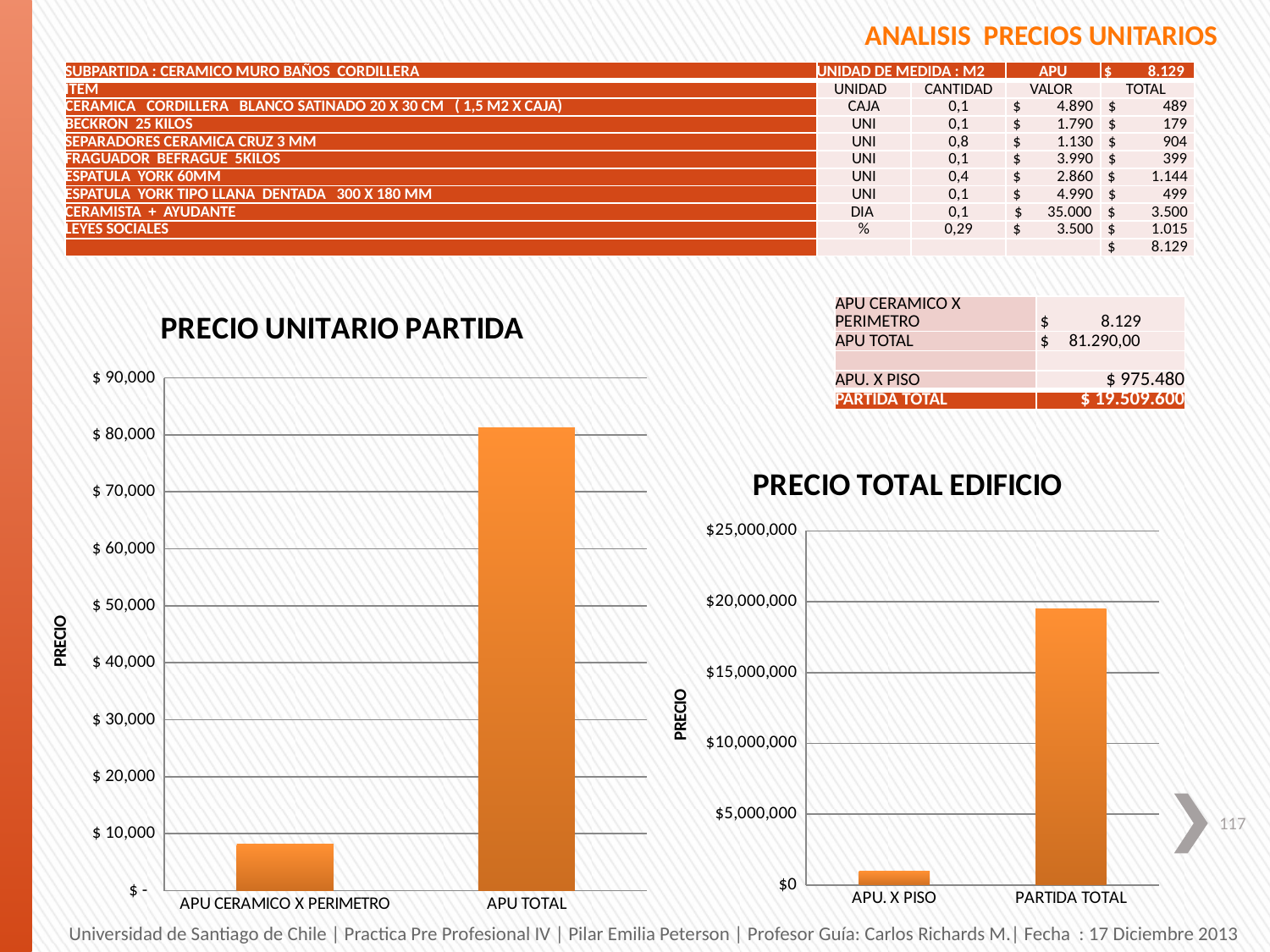
What kind of chart is the 'PRECIO UNITARIO PARTIDA' chart? bar chart In the 'PRECIO UNITARIO PARTIDA' chart, which category has the highest value? APU TOTAL What kind of chart is the 'PRECIO TOTAL EDIFICIO' chart? bar chart In the 'PRECIO UNITARIO PARTIDA' chart, is the value for APU CERAMICO X PERIMETRO greater or less than $ 10,000? less In the 'PRECIO TOTAL EDIFICIO' chart, is the value for PARTIDA TOTAL greater or less than $20,000,000? less In the 'PRECIO TOTAL EDIFICIO' chart, which is larger, APU. X PISO or PARTIDA TOTAL? PARTIDA TOTAL In the 'PRECIO UNITARIO PARTIDA' chart, which category has the lowest value? APU CERAMICO X PERIMETRO In the 'PRECIO UNITARIO PARTIDA' chart, is the value for APU TOTAL greater or less than $ 80,000? greater How many categories are shown in the 'PRECIO TOTAL EDIFICIO' chart? 2 What is the y-axis title of the 'PRECIO UNITARIO PARTIDA' chart? PRECIO How many categories are shown in the 'PRECIO UNITARIO PARTIDA' chart? 2